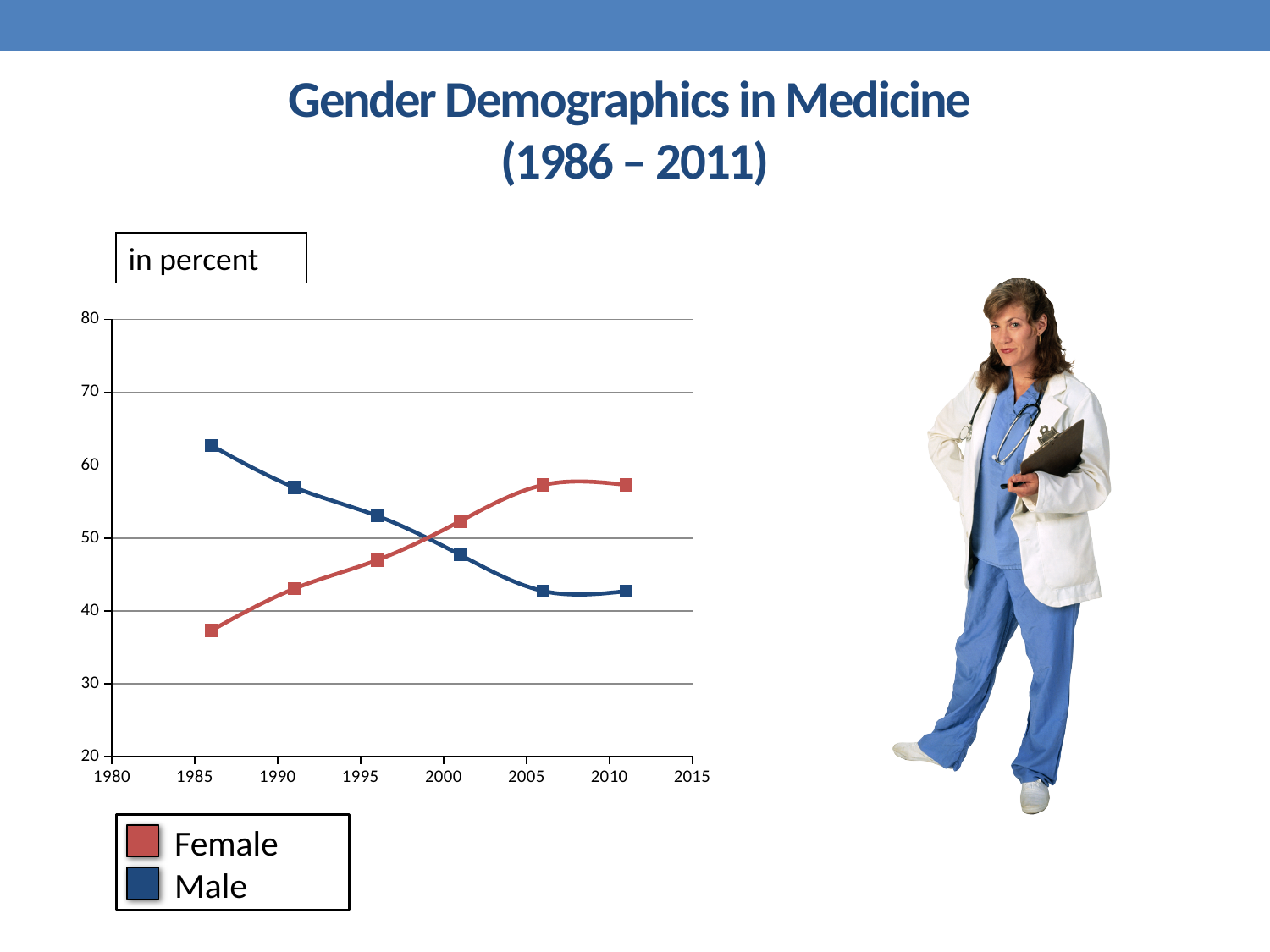
How many series does the legend list? 2 Is the value for Male in 1996 greater or less than 50? greater Is the value for Female in 1986 greater or less than 40? less What kind of chart is shown on the slide? line chart Does the Male series rise or fall from 1986 to 2006? fall In 1986, which series has the larger value, Female or Male? Male Which colour represents the Female series in the legend? red In 2011, which series has the larger value, Female or Male? Female Is the value for Male in 1986 greater or less than 60? greater Does the Female series rise or fall from 1986 to 2011? rise How many data points are plotted for the Female series? 6